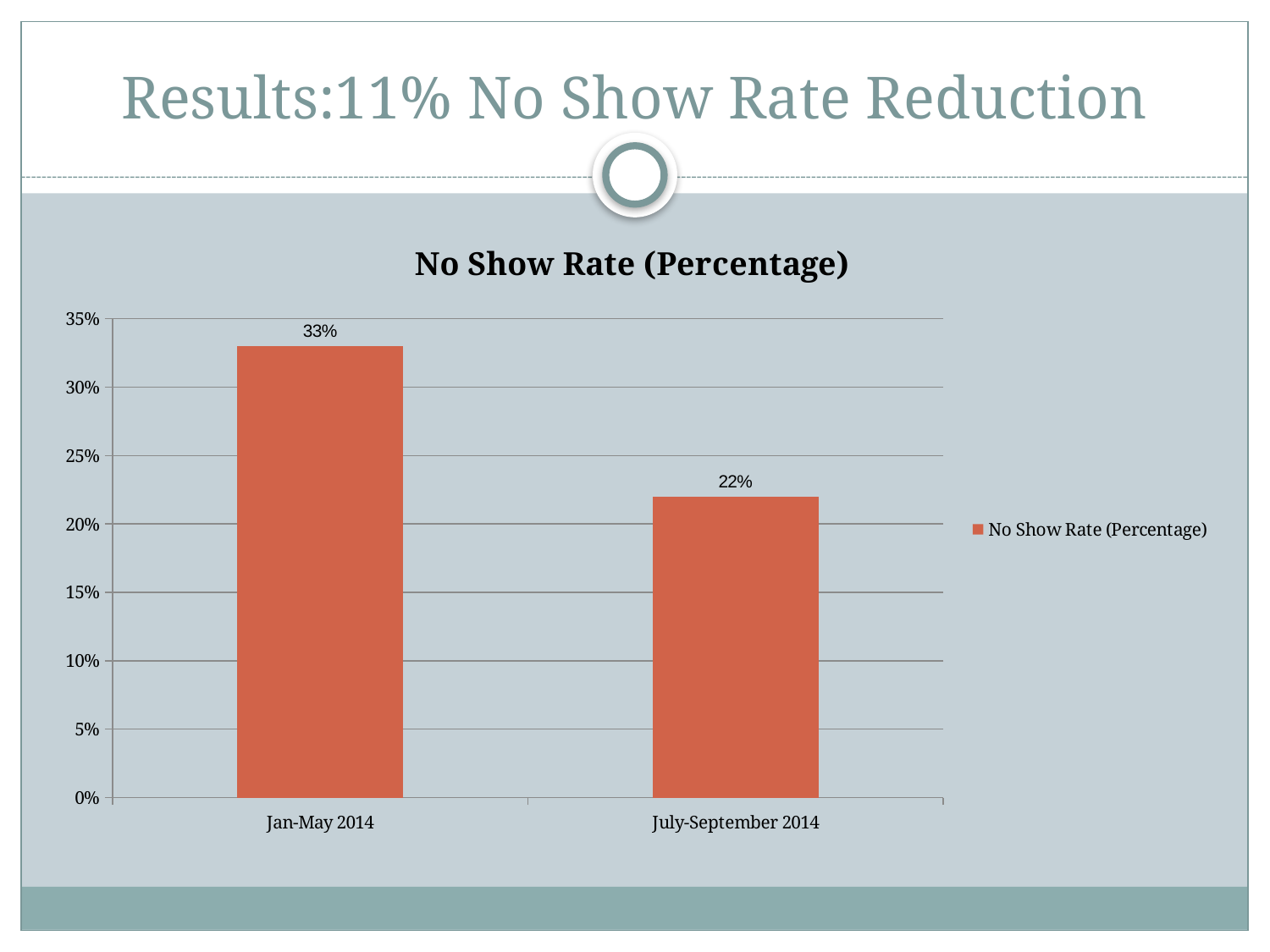
Which period has the lowest No Show Rate? July-September 2014 What is the difference between the No Show Rate for Jan-May 2014 and July-September 2014? 11% How many series does the legend list? 1 What is the No Show Rate for Jan-May 2014? 33% What is the title of the chart? No Show Rate (Percentage) Is the No Show Rate for Jan-May 2014 greater or less than 30%? greater Which period has the highest No Show Rate? Jan-May 2014 What kind of chart is shown on the slide? bar chart How many periods are shown on the x axis of the chart? 2 Is the No Show Rate for July-September 2014 greater or less than 25%? less What is the No Show Rate for July-September 2014? 22% Which is larger, the No Show Rate for Jan-May 2014 or for July-September 2014? Jan-May 2014